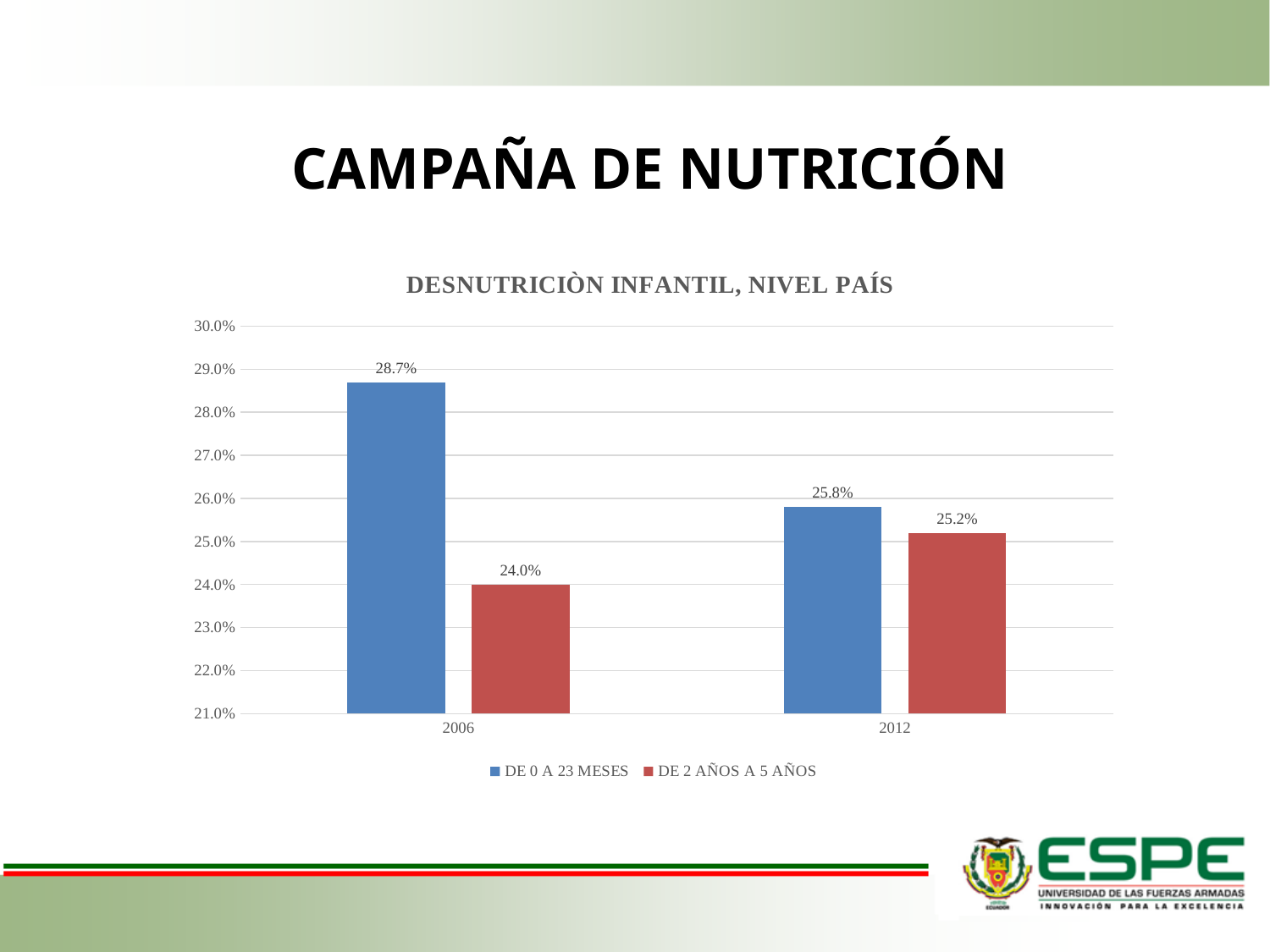
What kind of chart is shown? bar chart What is the title of the chart? DESNUTRICIÒN INFANTIL, NIVEL PAÍS What is the difference between the DE 0 A 23 MESES values in 2006 and 2012? 2.9% Is the value for DE 2 AÑOS A 5 AÑOS in 2006 greater or less than 25.0%? less In 2012, which series has the larger value, DE 0 A 23 MESES or DE 2 AÑOS A 5 AÑOS? DE 0 A 23 MESES What is the value for DE 2 AÑOS A 5 AÑOS in 2006? 24.0% What is the value for DE 0 A 23 MESES in 2006? 28.7% How many series does the legend list? 2 What is the value for DE 0 A 23 MESES in 2012? 25.8% Which year has the lowest value for DE 2 AÑOS A 5 AÑOS? 2006 What is the value for DE 2 AÑOS A 5 AÑOS in 2012? 25.2% Which year has the highest value for DE 0 A 23 MESES? 2006